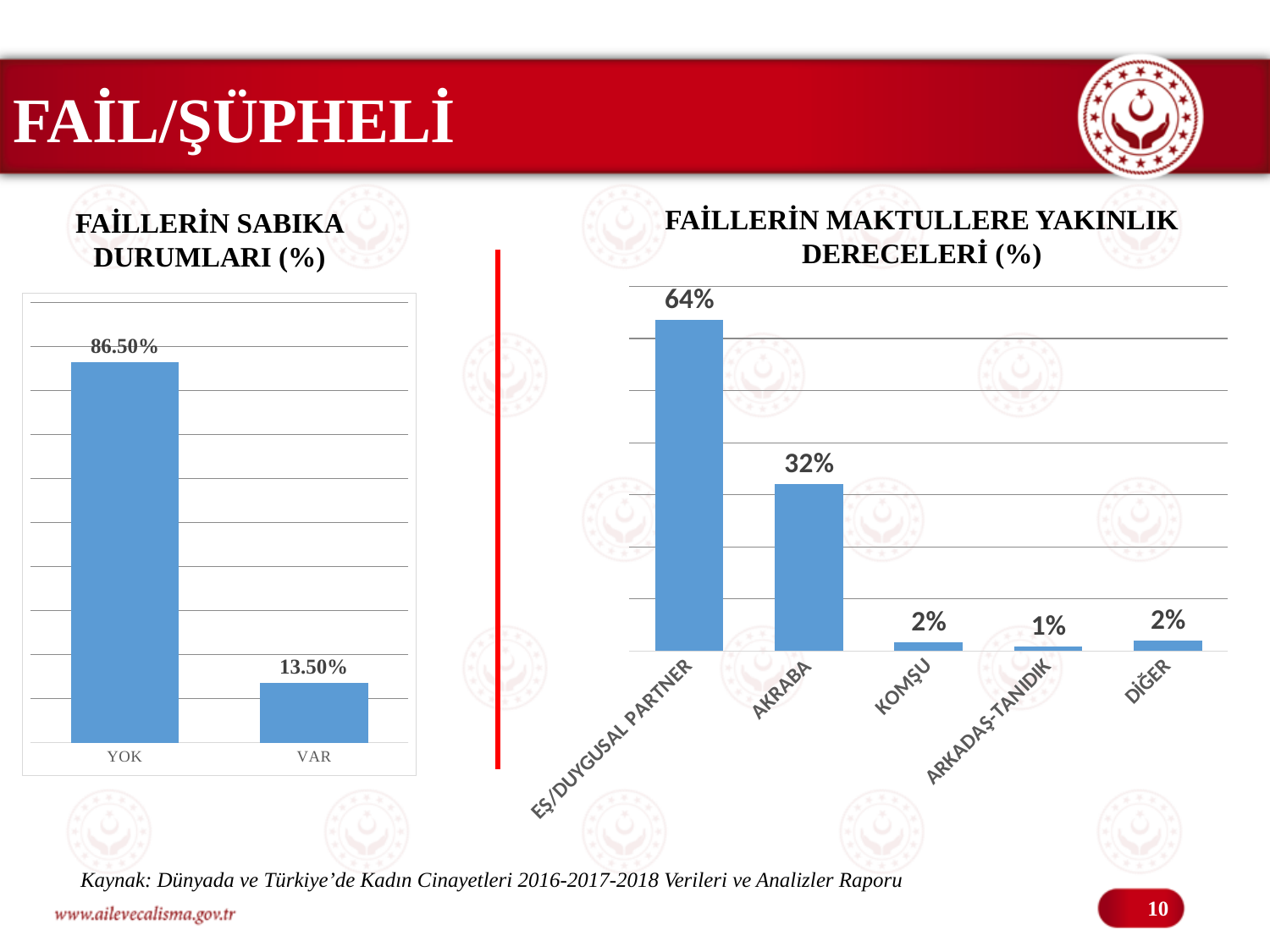
In the chart titled "FAİLLERİN MAKTULLERE YAKINLIK DERECELERİ (%)", what is the value for ARKADAŞ-TANIDIK? 1% In the chart titled "FAİLLERİN SABIKA DURUMLARI (%)", what is the difference between the values for YOK and VAR? 73.00% In the chart titled "FAİLLERİN SABIKA DURUMLARI (%)", what is the value for YOK? 86.50% In the chart titled "FAİLLERİN MAKTULLERE YAKINLIK DERECELERİ (%)", which category has the highest value? EŞ/DUYGUSAL PARTNER In the chart titled "FAİLLERİN MAKTULLERE YAKINLIK DERECELERİ (%)", how many categories are shown? 5 In the chart titled "FAİLLERİN MAKTULLERE YAKINLIK DERECELERİ (%)", what is the value for AKRABA? 32% In the chart titled "FAİLLERİN MAKTULLERE YAKINLIK DERECELERİ (%)", what is the difference between the values for EŞ/DUYGUSAL PARTNER and AKRABA? 32% In the chart titled "FAİLLERİN SABIKA DURUMLARI (%)", what is the value for VAR? 13.50% In the chart titled "FAİLLERİN MAKTULLERE YAKINLIK DERECELERİ (%)", which category has the lowest value? ARKADAŞ-TANIDIK In the chart titled "FAİLLERİN MAKTULLERE YAKINLIK DERECELERİ (%)", what is the value for EŞ/DUYGUSAL PARTNER? 64% What kind of chart is the chart titled "FAİLLERİN MAKTULLERE YAKINLIK DERECELERİ (%)"? Bar chart In the chart titled "FAİLLERİN SABIKA DURUMLARI (%)", how many categories are shown? 2